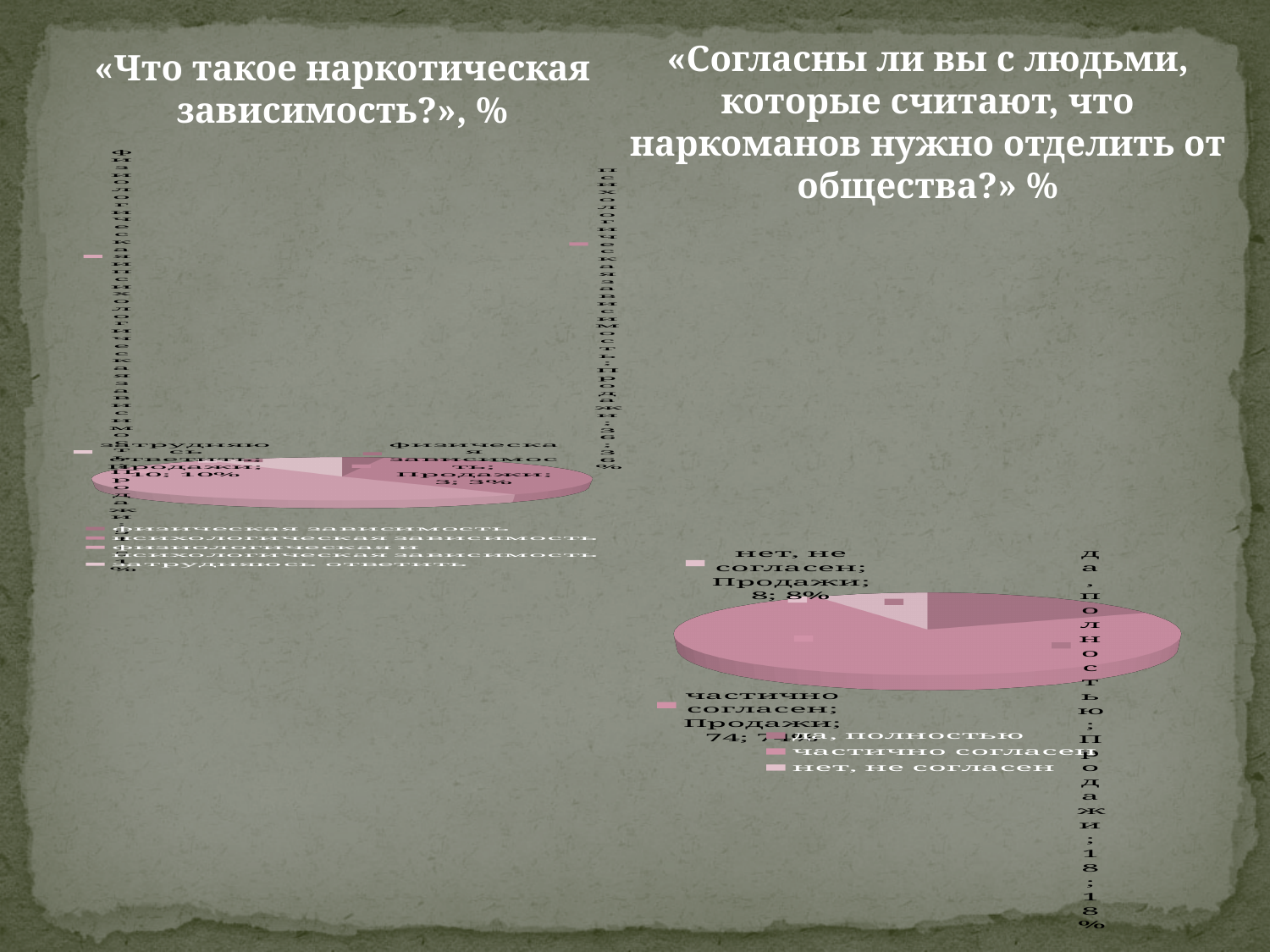
In the left chart («Что такое наркотическая зависимость?»), what share is shown for «затрудняюсь ответить»? 10% In the right chart («Согласны ли вы с людьми...»), which answer has the largest share? частично согласен In the right chart («Согласны ли вы с людьми...»), what share is shown for «частично согласен»? 74% In the right chart («Согласны ли вы с людьми...»), what share is shown for «нет, не согласен»? 8% In the left chart («Что такое наркотическая зависимость?»), what share is shown for «физическая зависимость»? 3% In the right chart («Согласны ли вы с людьми...»), by how many percentage points does «частично согласен» exceed «да, полностью»? 56 What type of chart is used on the left of the slide, titled «Что такое наркотическая зависимость?»? pie chart How many entries does the legend of the left chart («Что такое наркотическая зависимость?») list? 4 In the right chart («Согласны ли вы с людьми...»), what share is shown for «да, полностью»? 18% In the right chart («Согласны ли вы с людьми...»), which answer has the smallest share? нет, не согласен How many entries does the legend of the right chart («Согласны ли вы с людьми...») list? 3 What type of chart is used on the right of the slide, titled «Согласны ли вы с людьми, которые считают, что наркоманов нужно отделить от общества?»? pie chart